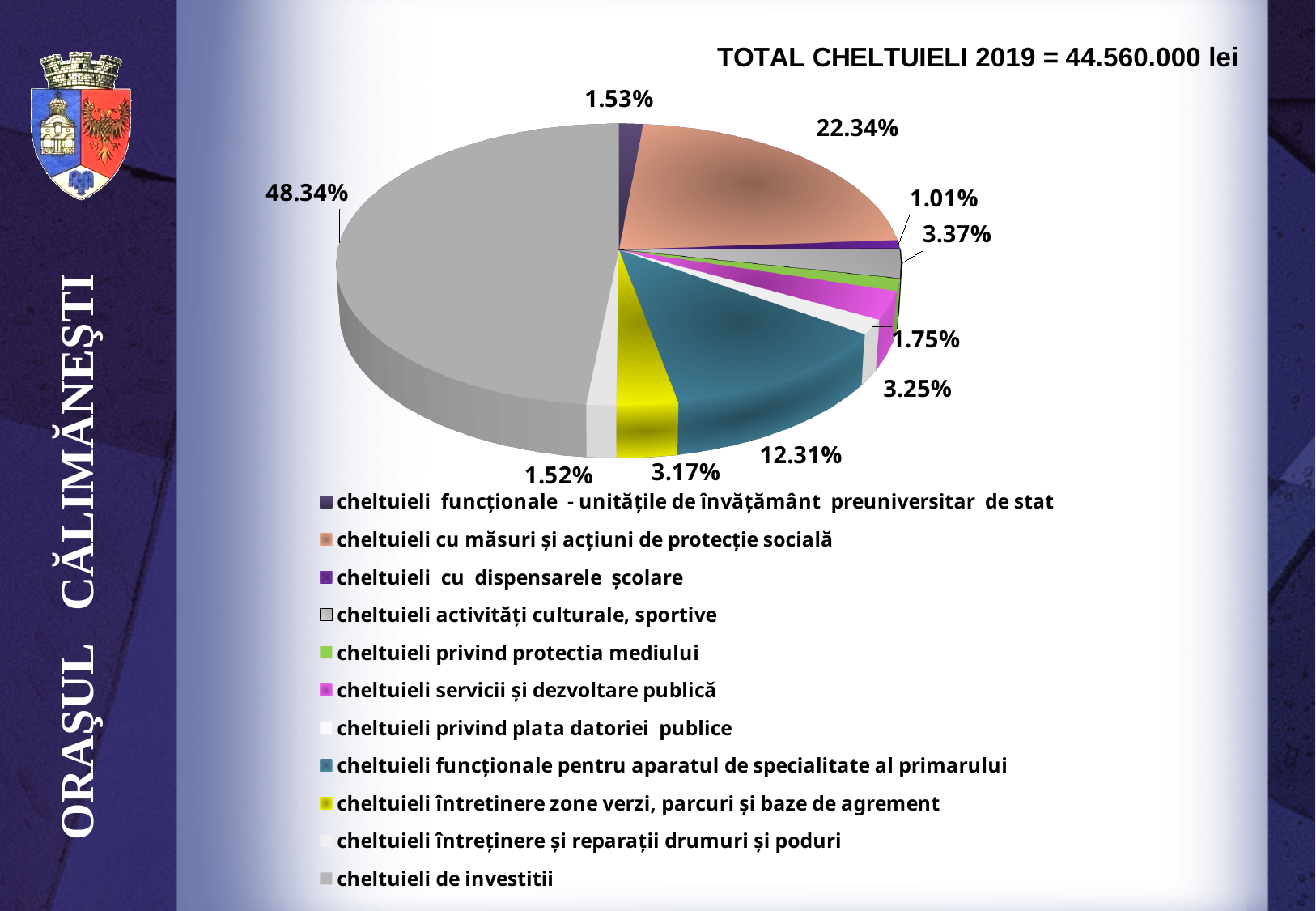
What is the difference in percentage points between 'cheltuieli de investitii' and 'cheltuieli cu măsuri și acțiuni de protecție socială'? 26.00% What percentage is shown for 'cheltuieli funcționale pentru aparatul de specialitate al primarului'? 12.31% Which labelled category has the smallest share of the pie? cheltuieli cu dispensarele școlare What percentage is shown for 'cheltuieli întretinere zone verzi, parcuri și baze de agrement'? 3.17% What share of the pie is 'cheltuieli de investitii'? 48.34% Which is larger: the share for 'cheltuieli funcționale pentru aparatul de specialitate al primarului' or for 'cheltuieli întretinere zone verzi, parcuri și baze de agrement'? cheltuieli funcționale pentru aparatul de specialitate al primarului Which category has the largest share of the pie? cheltuieli de investitii What percentage is shown for 'cheltuieli activități culturale, sportive'? 3.37% What type of chart is shown on the slide? pie chart What percentage is shown for 'cheltuieli cu măsuri și acțiuni de protecție socială'? 22.34% How many categories does the legend list? 11 What percentage is shown for 'cheltuieli cu dispensarele școlare'? 1.01%